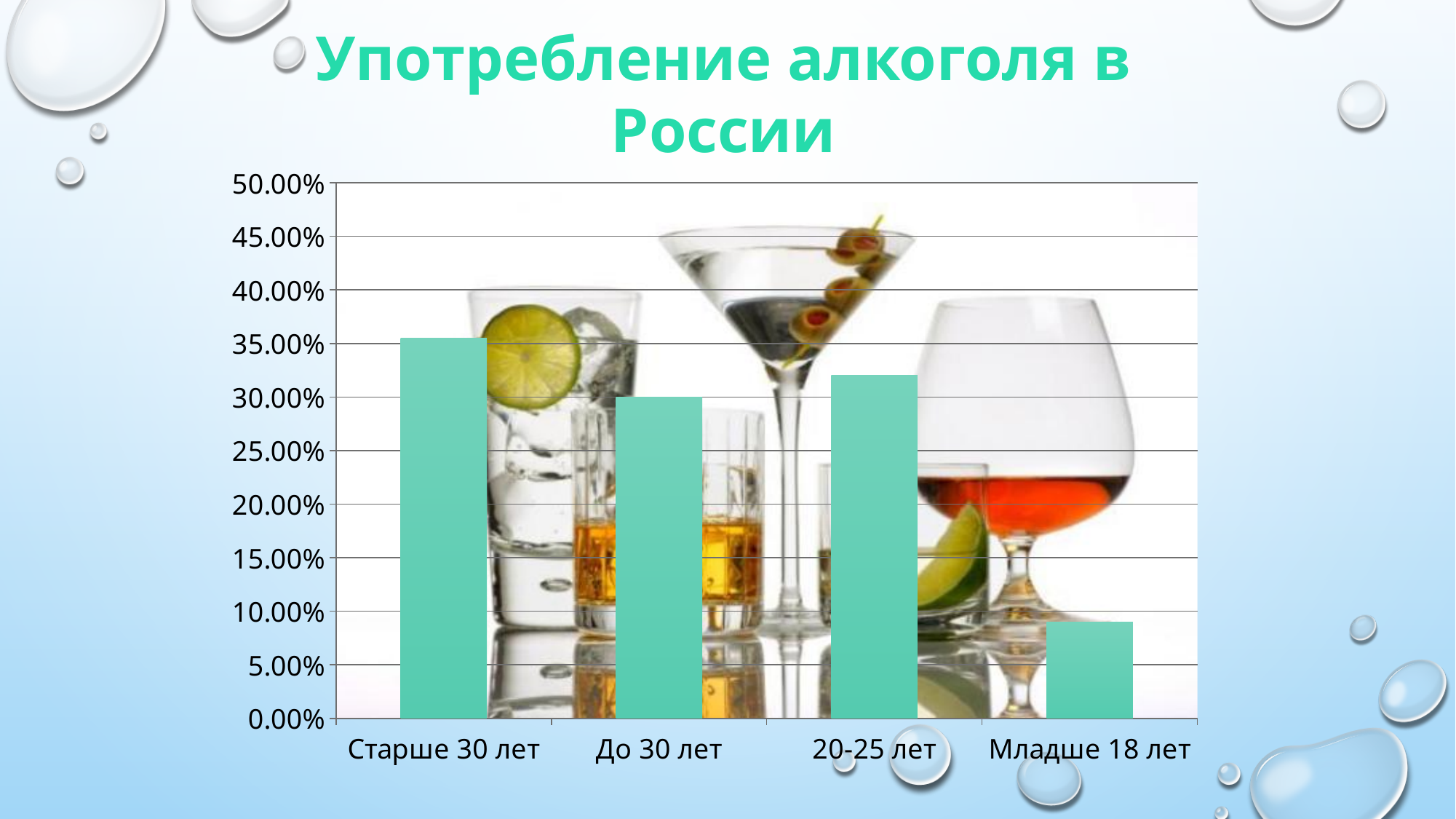
Is the value for До 30 лет greater or less than 25.00%? greater Which is larger, the value for Старше 30 лет or the value for Младше 18 лет? Старше 30 лет Is the value for 20-25 лет greater or less than 35.00%? less Is the value for Младше 18 лет greater or less than 10.00%? less What is the title of the chart? Употребление алкоголя в России What type of chart is shown on the slide? bar chart What is the highest value shown on the y axis of the chart? 50.00% Which category has the lowest bar? Младше 18 лет Which is larger, the value for 20-25 лет or the value for До 30 лет? 20-25 лет How many categories are shown on the x axis of the chart? 4 Which category has the highest bar? Старше 30 лет